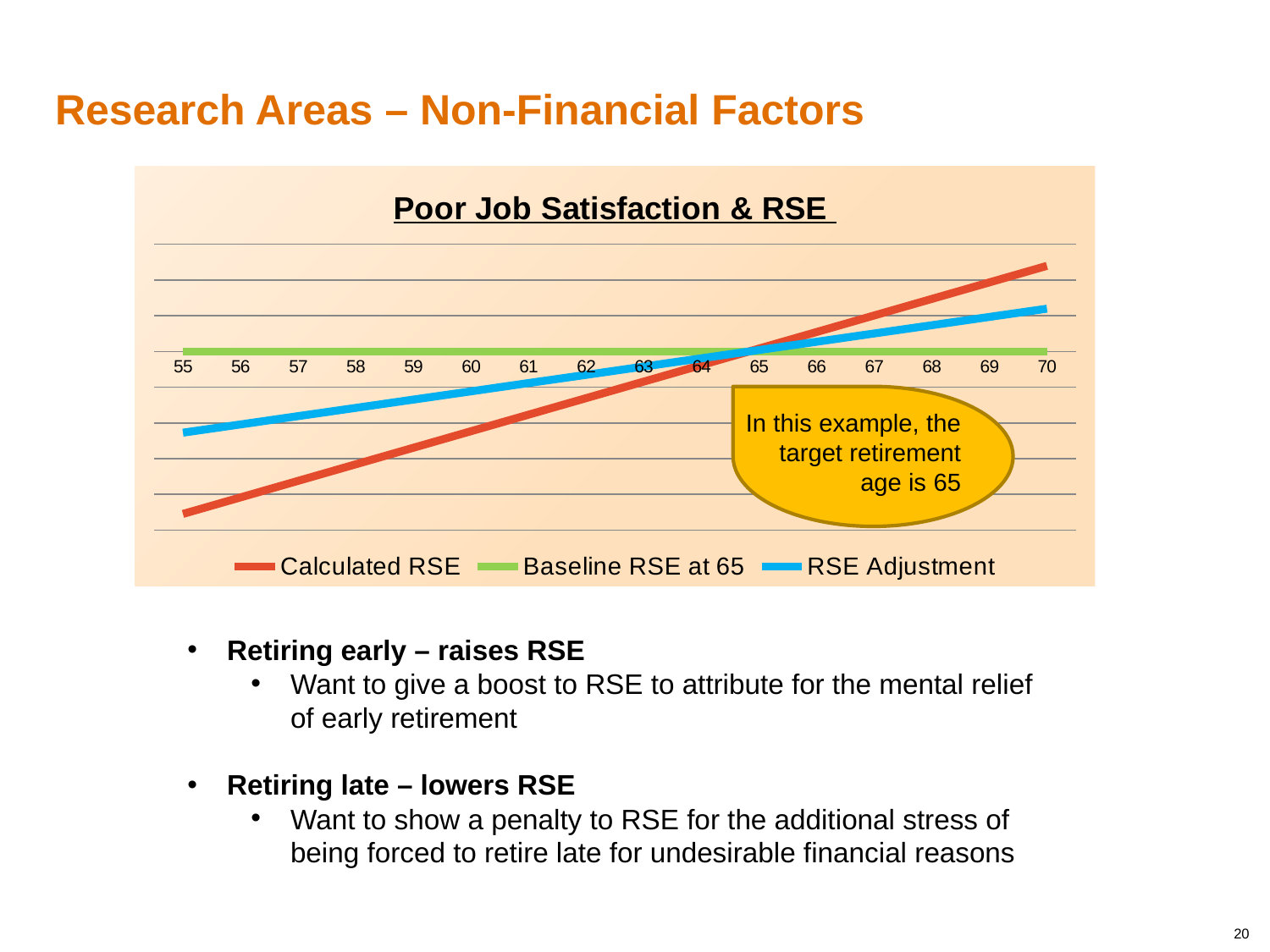
Does the Baseline RSE at 65 line rise, fall, or stay flat across the ages shown? stays flat Does the RSE Adjustment line rise or fall as age increases from 55 to 70? rises At age 55, which is larger: Calculated RSE or RSE Adjustment? RSE Adjustment At age 70, which series has the highest value? Calculated RSE What kind of chart is shown on the slide? line chart How many series does the chart legend list? 3 At age 70, which is larger: Baseline RSE at 65 or RSE Adjustment? RSE Adjustment What is the title of the chart? Poor Job Satisfaction & RSE At age 55, which series has the lowest value? Calculated RSE Does the Calculated RSE line rise or fall as age increases from 55 to 70? rises How many age values are shown along the x axis of the chart? 16 What is the first age shown on the x axis of the chart? 55